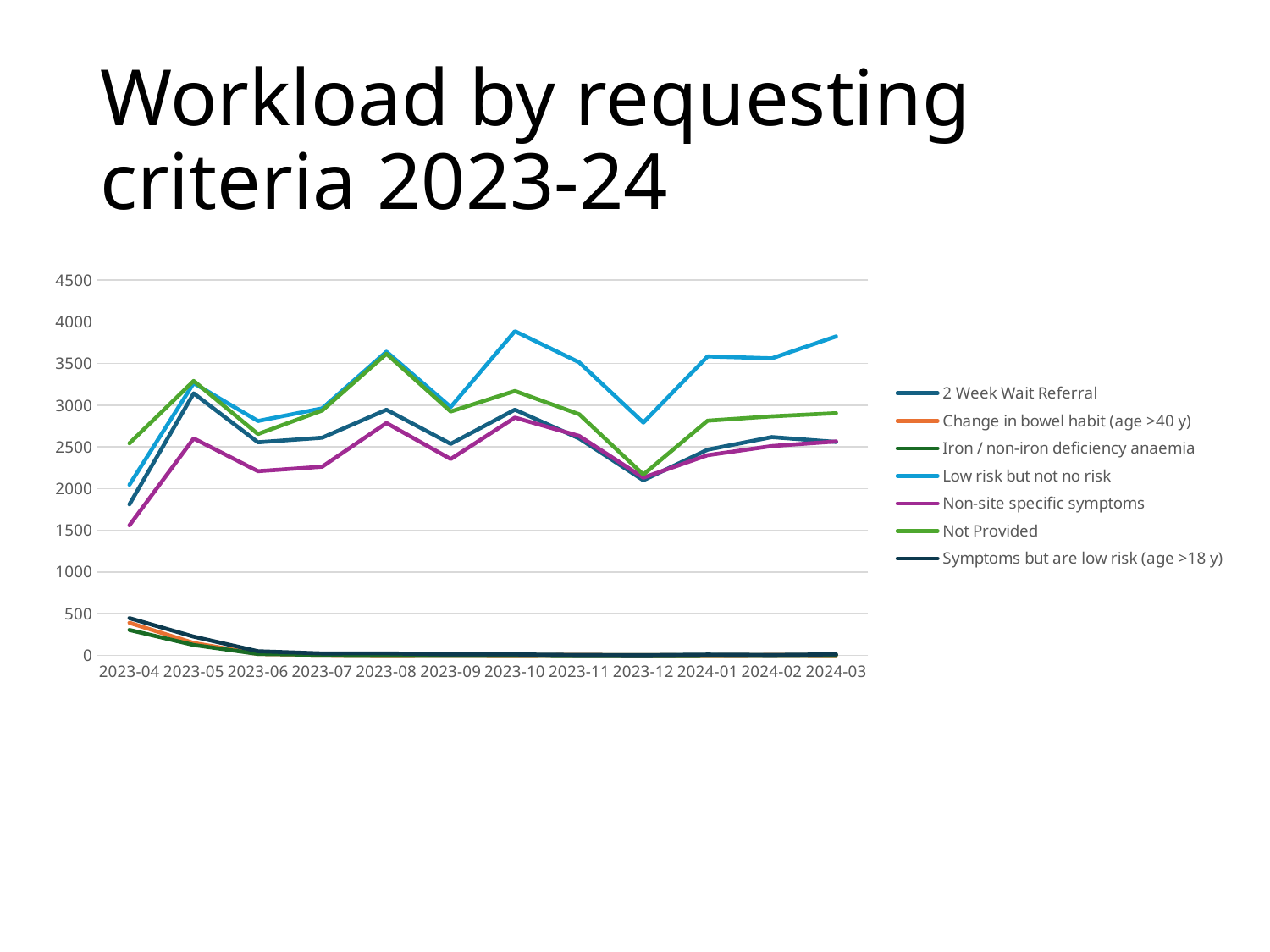
How many series does the legend list? 7 In 2023-04, which is higher: Not Provided or 2 Week Wait Referral? Not Provided In 2024-03, which is higher: Low risk but not no risk or Not Provided? Low risk but not no risk What kind of chart is shown on the slide? line chart How many months are plotted along the x axis? 12 Is the value for Low risk but not no risk in 2023-10 greater or less than 3500? greater What is the title of the slide? Workload by requesting criteria 2023-24 In which month does the Low risk but not no risk series reach its highest value? 2023-10 In which month does the 2 Week Wait Referral series have its lowest value? 2023-04 Is the value for Non-site specific symptoms in 2023-04 greater or less than 2000? less In which month does the Not Provided series reach its lowest value? 2023-12 Is the value for 2 Week Wait Referral in 2023-05 greater or less than 3000? greater